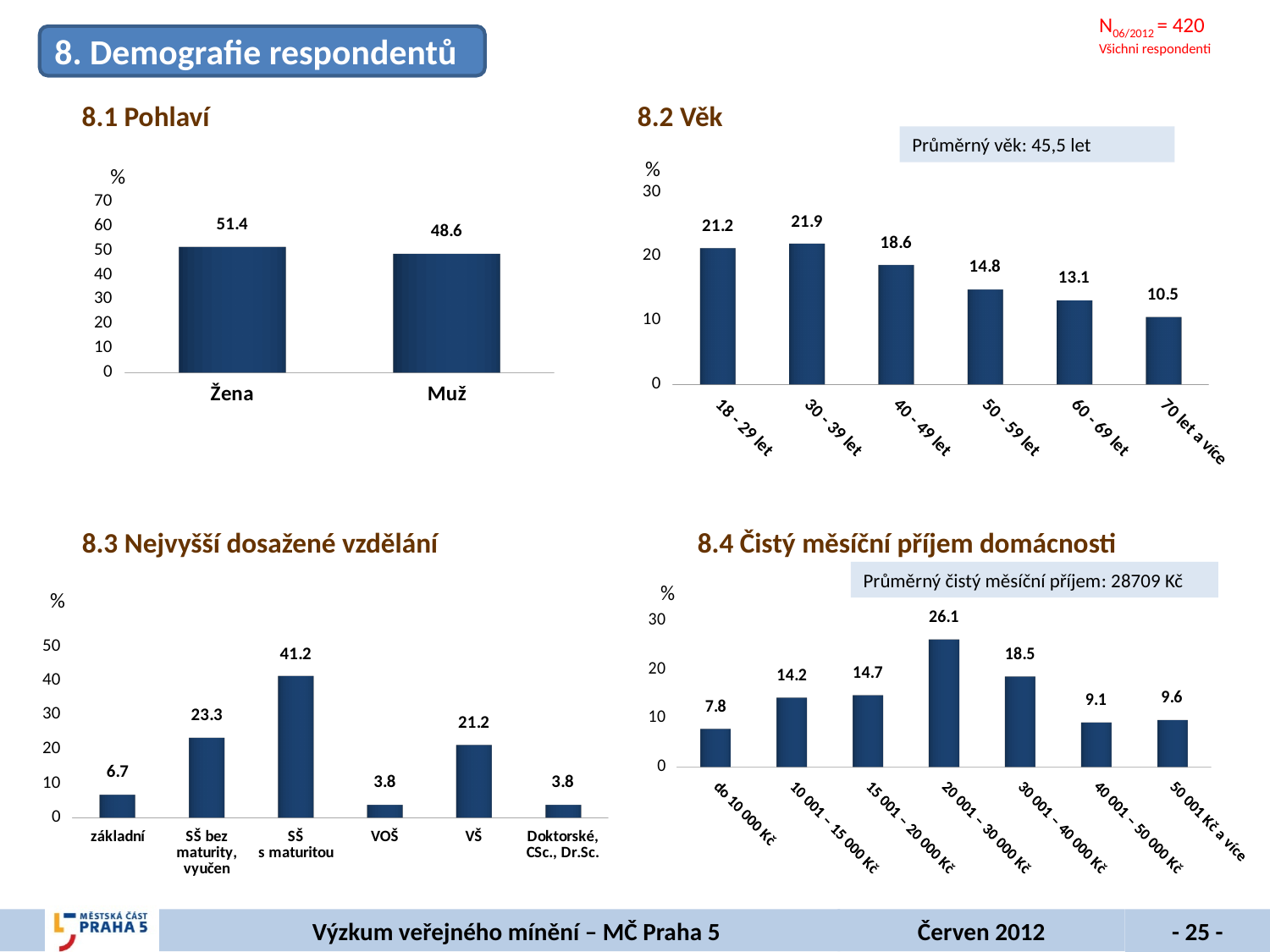
In the 8.4 Čistý měsíční příjem domácnosti chart, which is larger: 40 001 – 50 000 Kč or 50 001 Kč a více? 50 001 Kč a více In the 8.2 Věk chart, what is the value for 50 - 59 let? 14.8 In the 8.3 Nejvyšší dosažené vzdělání chart, what is the difference between SŠ bez maturity, vyučen and VŠ? 2.1 In the 8.4 Čistý měsíční příjem domácnosti chart, which income category has the lowest value? do 10 000 Kč In the 8.1 Pohlaví chart, what is the value for Žena? 51.4 In the 8.3 Nejvyšší dosažené vzdělání chart, which category has the highest value? SŠ s maturitou In the 8.3 Nejvyšší dosažené vzdělání chart, what is the value for základní? 6.7 What type of chart is the 8.1 Pohlaví chart? bar chart In the 8.4 Čistý měsíční příjem domácnosti chart, what is the value for 20 001 – 30 000 Kč? 26.1 In the 8.2 Věk chart, which age category has the highest value? 30 - 39 let In the 8.2 Věk chart, how many age categories are shown? 6 In the 8.2 Věk chart, do the values rise or fall from 30 - 39 let to 70 let a více? fall